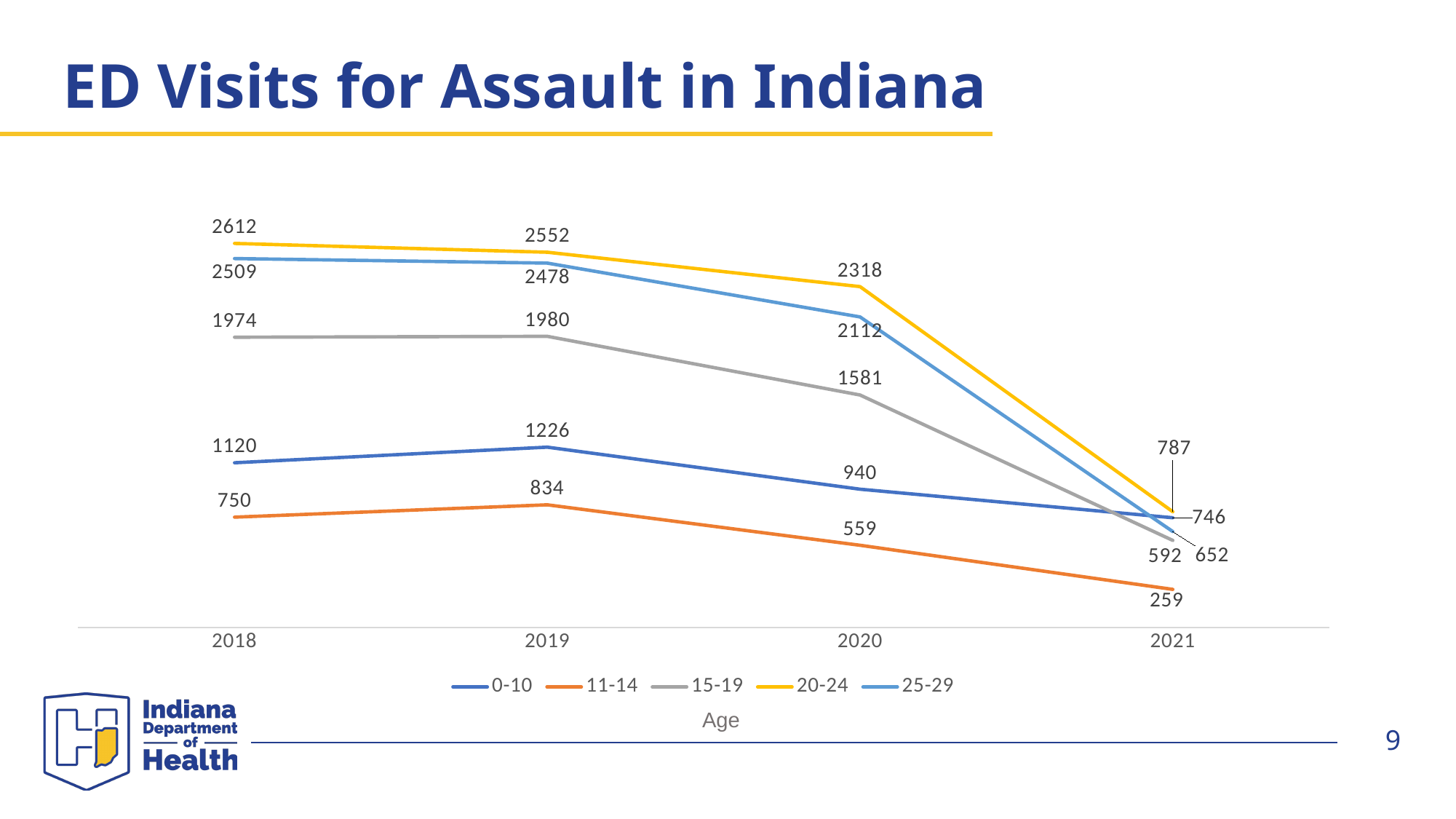
What is the difference between the 20-24 value and the 25-29 value in 2020? 206 Does the 25-29 series rise or fall from 2018 to 2021? fall How many series does the legend list? 5 What is the title of the chart? ED Visits for Assault in Indiana What is the value for the 11-14 age group in 2021? 259 What is the value for the 20-24 age group in 2018? 2612 Which age group has the highest value in 2019? 20-24 How many years are shown on the x axis? 4 What type of chart is shown on the slide? line chart What is the value for the 15-19 age group in 2020? 1581 Which is larger in 2021, the value for 0-10 or the value for 25-29? 0-10 Which age group has the lowest value in 2020? 11-14